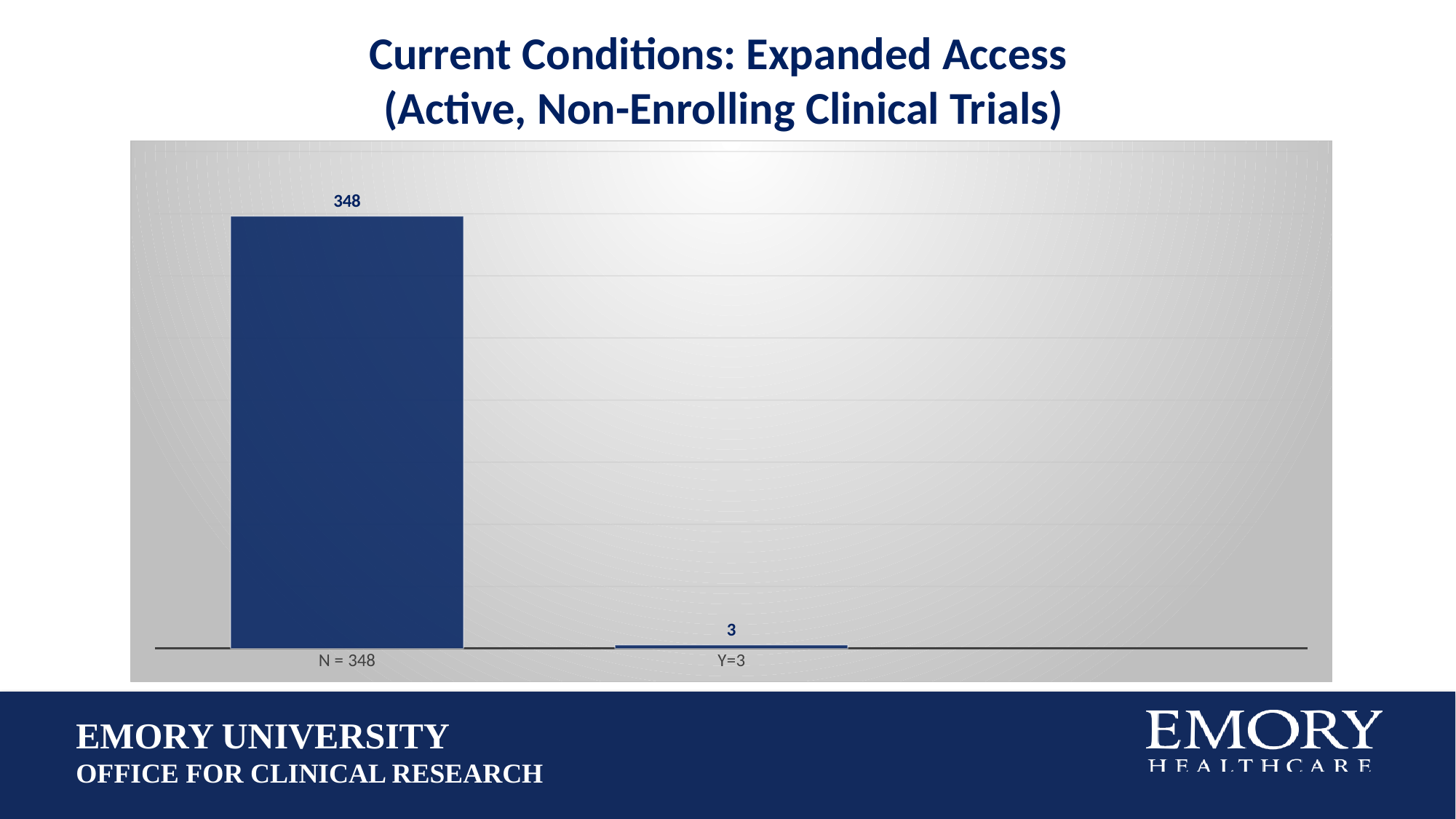
Which is larger, the value for "N = 348" or the value for "Y=3"? N = 348 Which category has the highest value? N = 348 Which category has the lowest value? Y=3 How many bars are shown in the chart? 2 What is the value of the bar labeled "Y=3"? 3 What is the difference between the values for "N = 348" and "Y=3"? 345 What is the title of the slide containing the chart? Current Conditions: Expanded Access (Active, Non-Enrolling Clinical Trials) What is the total of the two bar values shown in the chart? 351 What kind of chart is shown on the slide? Bar chart What is the value of the bar labeled "N = 348"? 348 What colour are the bars in the chart? Dark blue